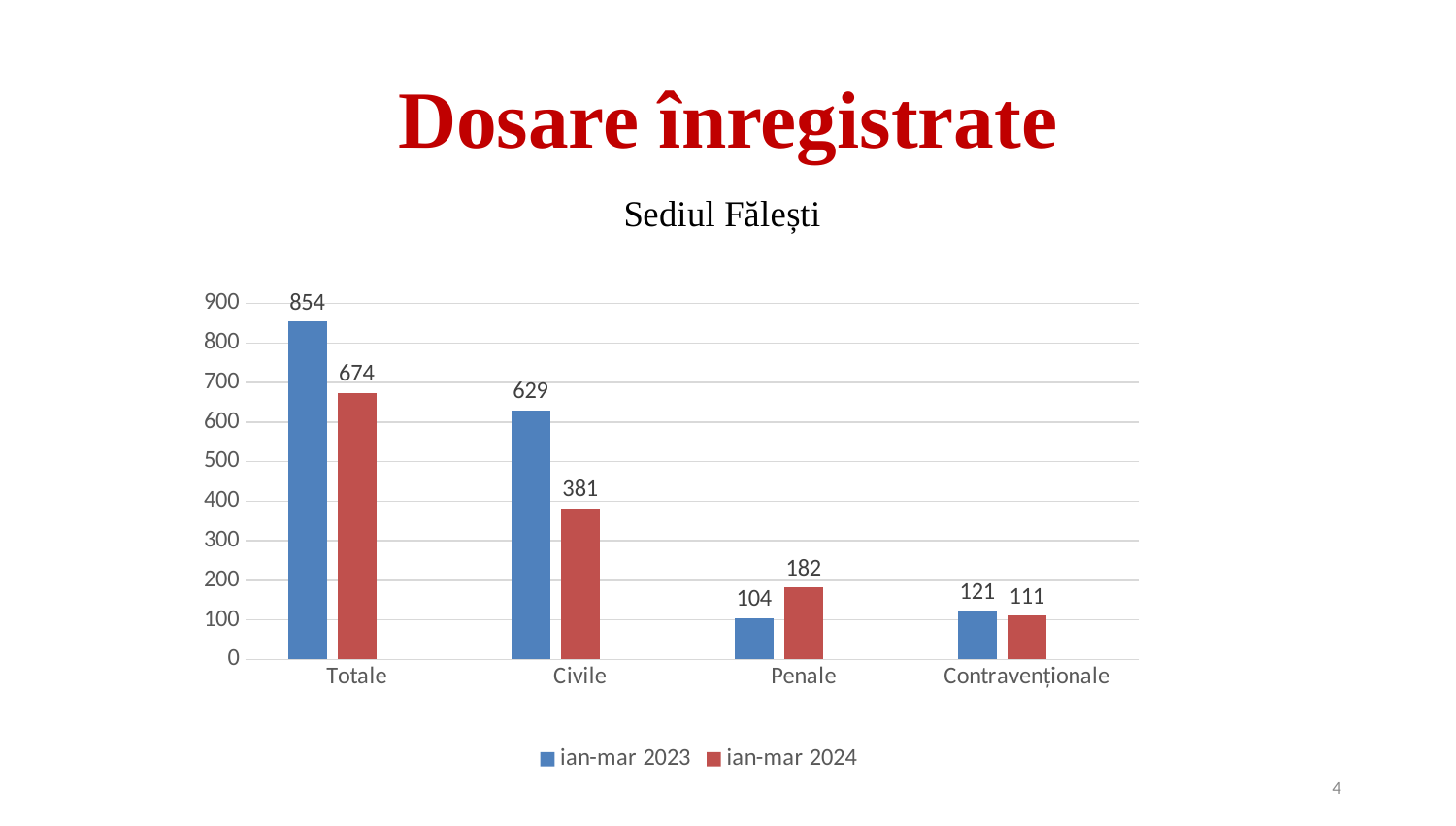
What is the value for Civile in the ian-mar 2024 series? 381 Which category has the highest value in the ian-mar 2024 series? Totale How many series does the legend list? 2 Which is larger for Penale: the ian-mar 2023 value or the ian-mar 2024 value? ian-mar 2024 What is the value for Penale in the ian-mar 2023 series? 104 What is the value for Totale in the ian-mar 2023 series? 854 How many categories are shown on the x axis? 4 What is the subtitle shown above the chart? Sediul Fălești What kind of chart is shown on the slide? bar chart What is the difference between the ian-mar 2023 and ian-mar 2024 values for Civile? 248 What is the value for Contravenționale in the ian-mar 2024 series? 111 Which category has the lowest value in the ian-mar 2023 series? Penale